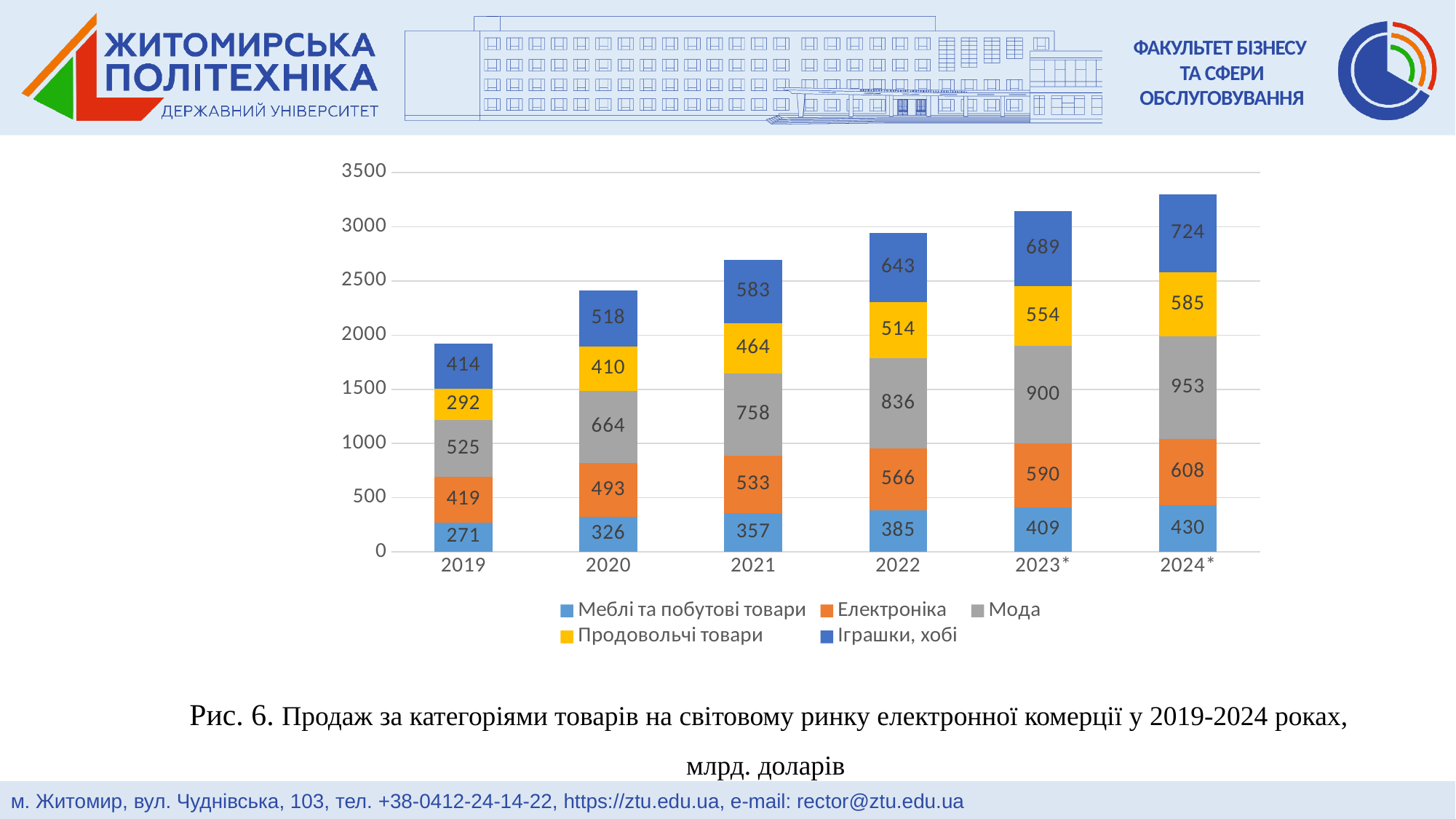
What is the value for Мода in 2021? 758 How many years are shown on the x axis? 6 In which year is the value for Іграшки, хобі the highest? 2024* What is the total of the stacked bar for 2019? 1921 What is the difference between the Мода values in 2023* and 2022? 64 Do the values for Мода rise or fall from 2019 to 2024*? Rise What kind of chart is shown on the slide? Stacked bar chart In which year is the value for Меблі та побутові товари the lowest? 2019 Which is larger in 2020: the value for Електроніка or the value for Іграшки, хобі? Іграшки, хобі How many series does the legend list? 5 What is the value for Продовольчі товари in 2019? 292 What is the value for Електроніка in 2024*? 608